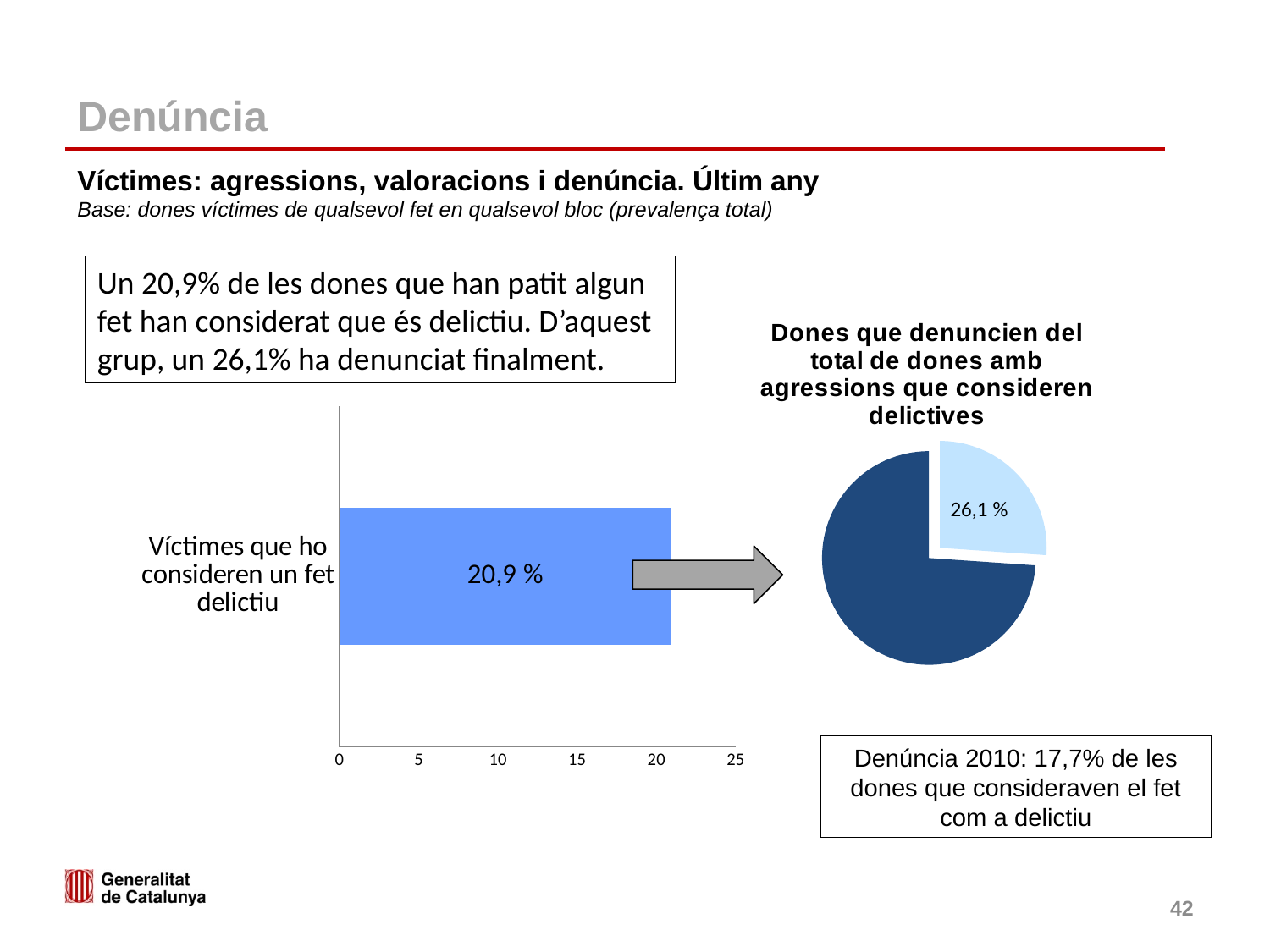
In the bar chart on the left, what is the highest value shown on the x axis? 25 In the pie chart on the right, how many slices are there? 2 In the bar chart on the left, is the value for 'Víctimes que ho consideren un fet delictiu' greater or less than 20? greater What is the title of the pie chart on the right? Dones que denuncien del total de dones amb agressions que consideren delictives What kind of chart is the chart on the right of the slide? pie chart What kind of chart is the chart on the left of the slide? bar chart In the pie chart on the right, what value is printed on the light blue slice? 26,1 % In the bar chart on the left, how many categories are plotted? 1 In the bar chart on the left, is the value for 'Víctimes que ho consideren un fet delictiu' greater or less than 25? less In the pie chart on the right, which slice is larger, the dark blue one or the light blue one? the dark blue one In the bar chart on the left, what is the value for 'Víctimes que ho consideren un fet delictiu'? 20,9 %